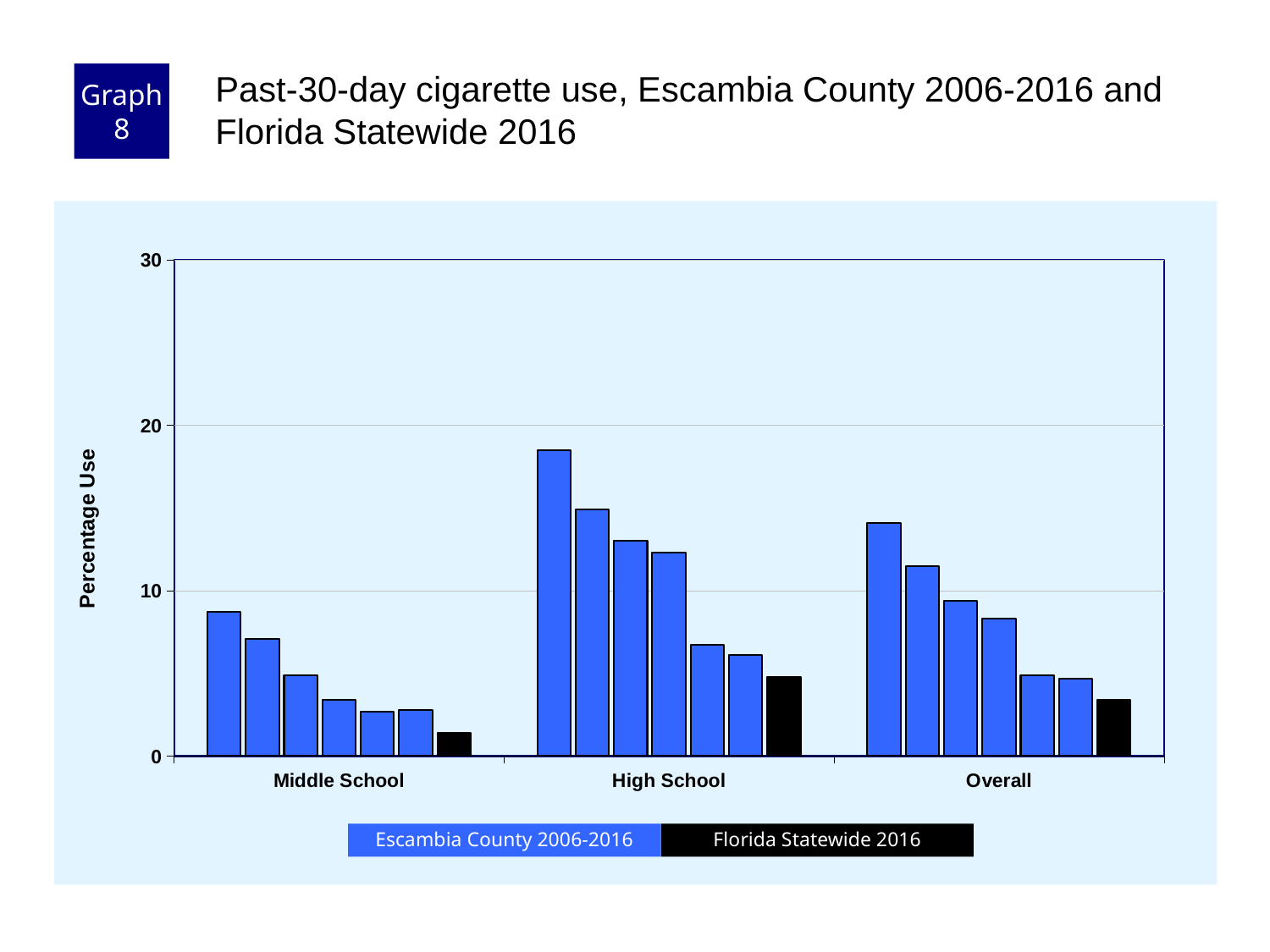
How many series does the legend list? 2 Is the value of the tallest Escambia County bar in the Middle School group greater or less than 10? less What is the label of the y axis? Percentage Use Is the Florida Statewide 2016 value for High School greater or less than 10? less Which colour represents Florida Statewide 2016 in the legend? black Which category group contains the shortest bar on the chart? Middle School Which is larger, the Florida Statewide 2016 bar for High School or the Florida Statewide 2016 bar for Middle School? High School Which category group contains the tallest bar on the chart? High School Within the High School group, do the Escambia County 2006-2016 bars rise or fall from left to right? fall What kind of chart is shown on the slide? bar chart How many categories are shown along the x axis? 3 Is the value of the tallest Escambia County bar in the High School group greater or less than 10? greater